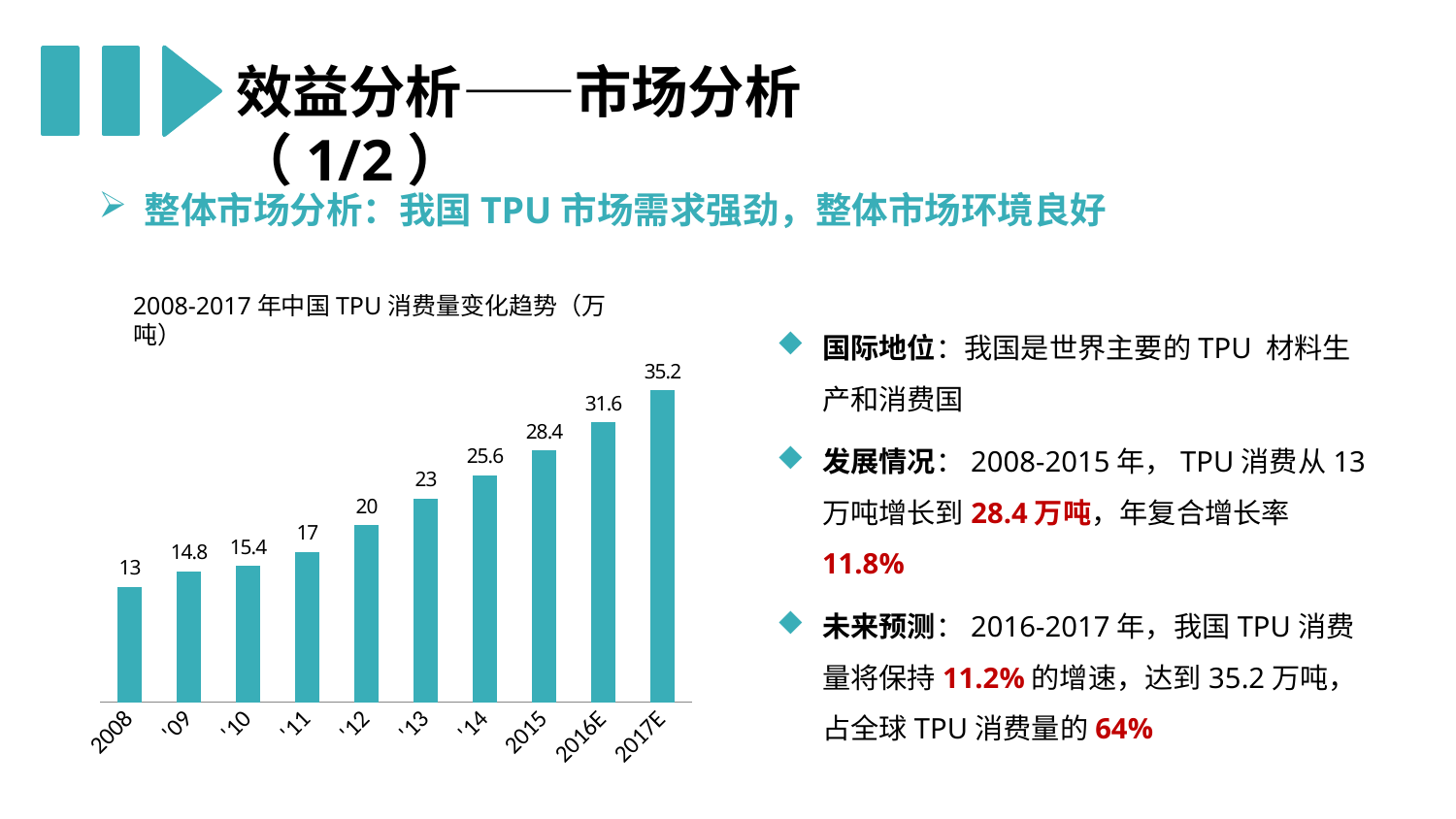
How many bars are shown in the chart? 10 Which category has the lowest value in the chart? 2008 Do the values rise or fall from 2008 to 2017E? Rise What is the value for 2008 in the chart? 13 What is the difference between the values for 2017E and 2016E? 3.6 What is the difference between the values for 2015 and 2008? 15.4 What is the value for '12 in the chart? 20 Which is larger, the value for '13 or the value for '11? '13 What kind of chart is shown on the slide? Bar chart What is the value for 2017E in the chart? 35.2 What is the value for 2015 in the chart? 28.4 Which category has the highest value in the chart? 2017E